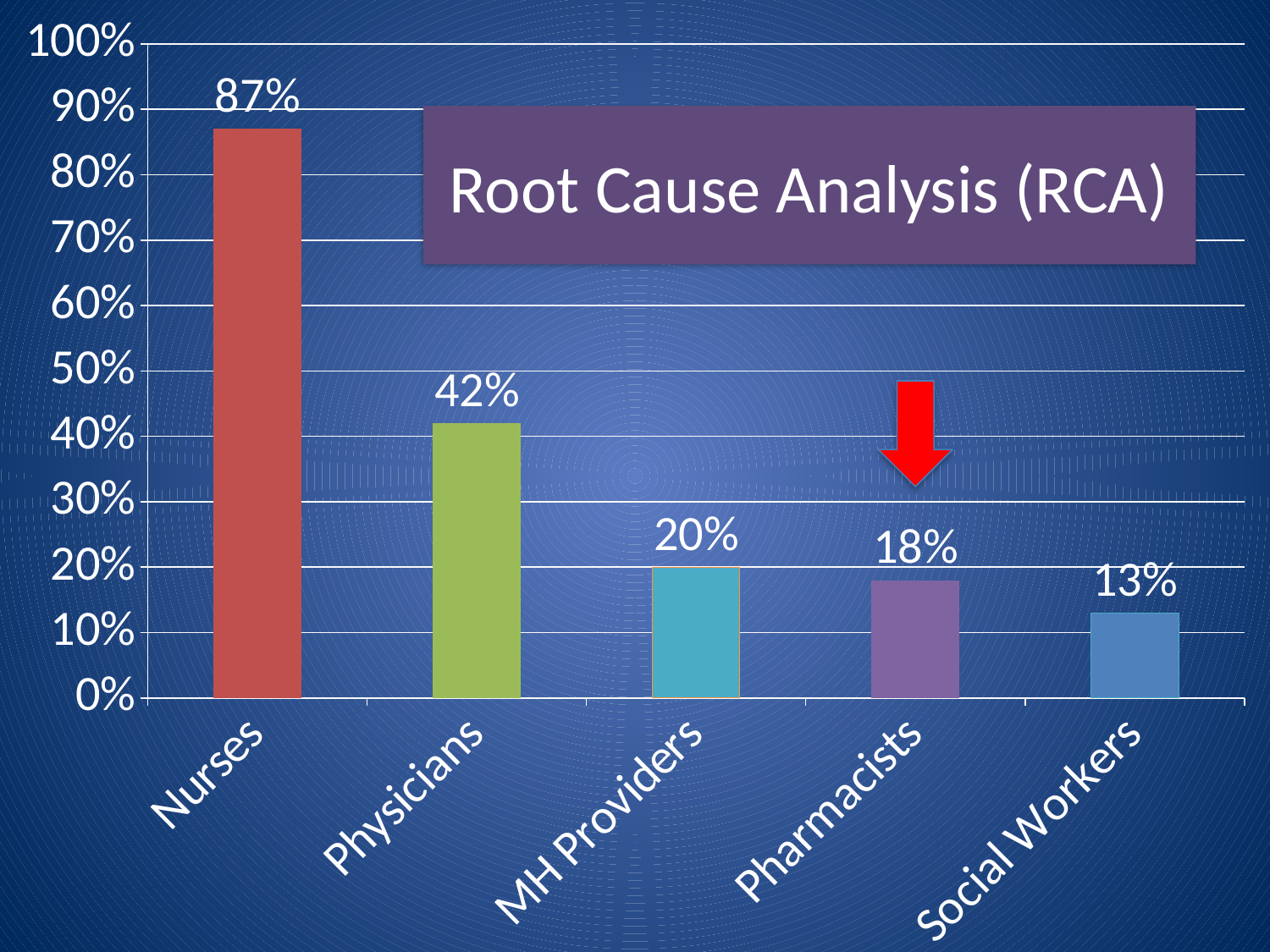
Which category has the highest value? Nurses What is the difference between the values for Nurses and Physicians? 45% Which category has the lowest value? Social Workers What is the value for Nurses? 87% What is the value for Physicians? 42% What kind of chart is shown on the slide? Bar chart What is the value for MH Providers? 20% What is the value for Social Workers? 13% Which is larger, the value for Physicians or the value for MH Providers? Physicians What is the title shown on the slide? Root Cause Analysis (RCA) What is the value for Pharmacists? 18% How many categories are shown on the x axis? 5